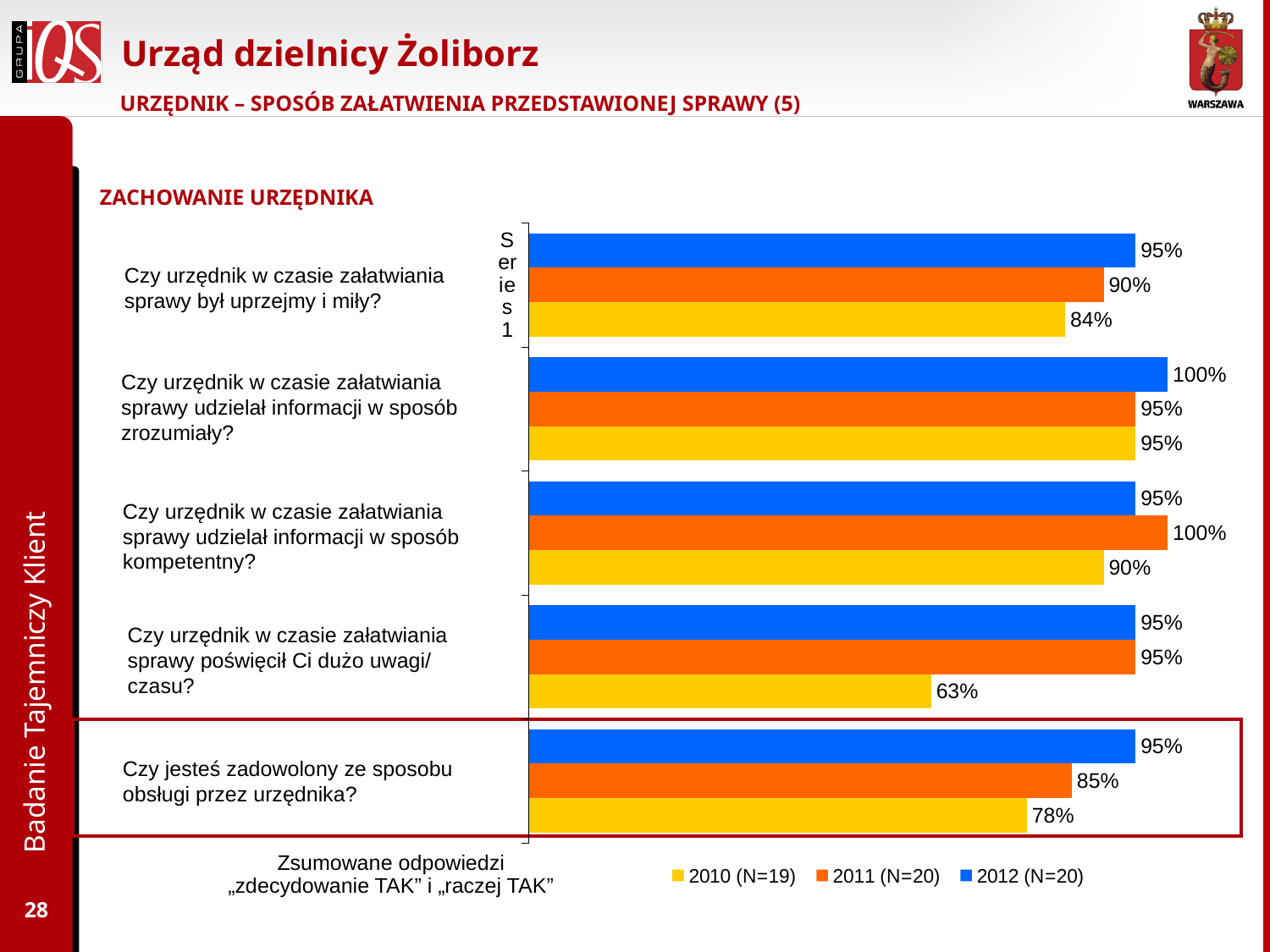
How many series does the legend list? 3 What is the 2011 (N=20) value for "Czy jesteś zadowolony ze sposobu obsługi przez urzędnika?"? 85% What is the 2011 (N=20) value for "Czy urzędnik w czasie załatwiania sprawy udzielał informacji w sposób kompetentny?"? 100% Which question has the highest 2012 (N=20) value? Czy urzędnik w czasie załatwiania sprawy udzielał informacji w sposób zrozumiały? What is the difference between the 2012 (N=20) and 2010 (N=19) values for "Czy jesteś zadowolony ze sposobu obsługi przez urzędnika?"? 17% How many questions (categories) are shown in the chart? 5 What is the 2010 (N=19) value for "Czy urzędnik w czasie załatwiania sprawy poświęcił Ci dużo uwagi/ czasu?"? 63% Which colour represents the 2012 (N=20) series in the chart? Blue What is the 2012 (N=20) value for "Czy urzędnik w czasie załatwiania sprawy był uprzejmy i miły?"? 95% For "Czy urzędnik w czasie załatwiania sprawy był uprzejmy i miły?", which is larger: the 2011 (N=20) value or the 2010 (N=19) value? 2011 (N=20) What kind of chart is shown on the slide? Bar chart Which question has the lowest 2010 (N=19) value? Czy urzędnik w czasie załatwiania sprawy poświęcił Ci dużo uwagi/ czasu?